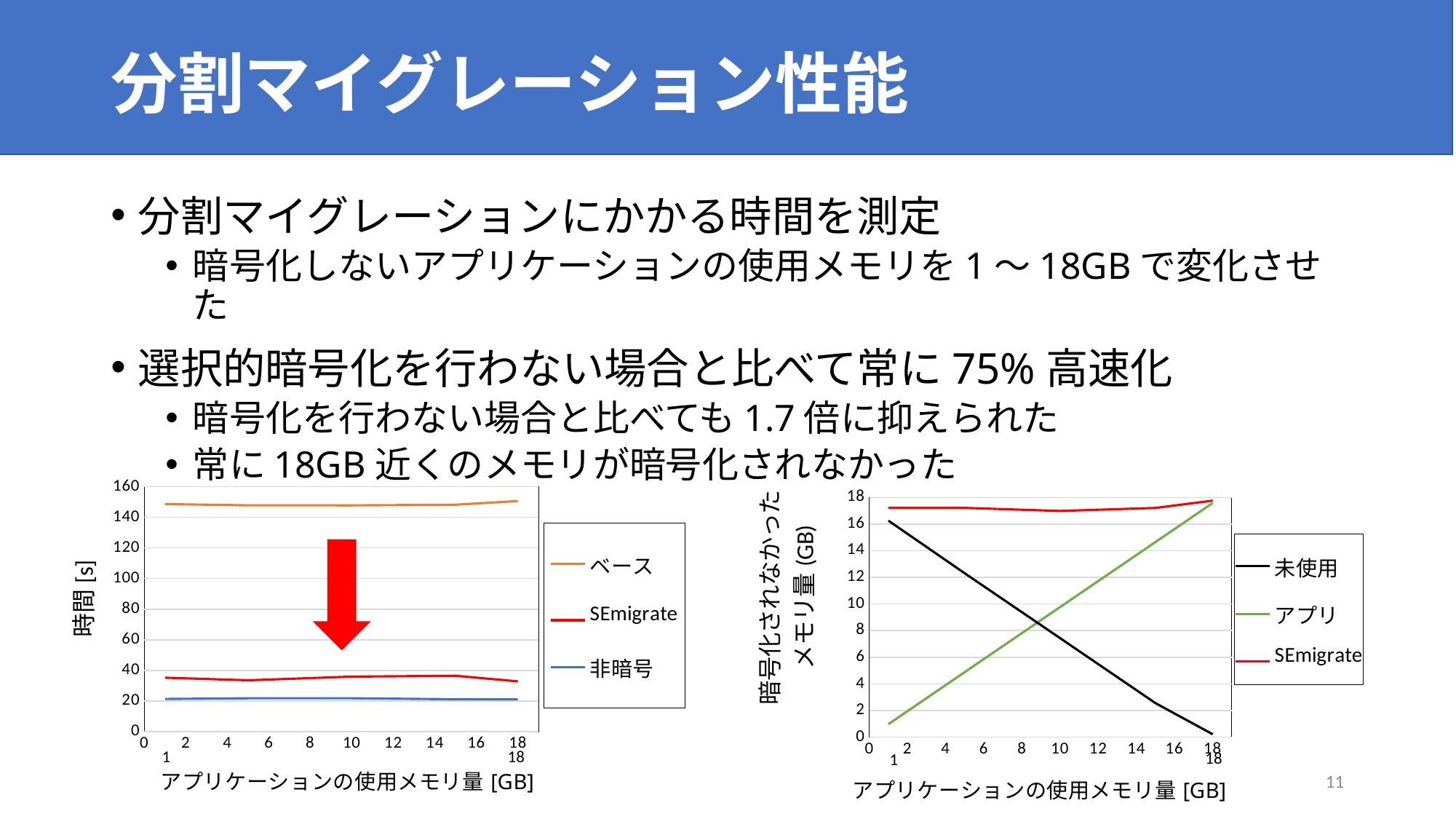
In the left chart, is the value for ベース at 10 GB greater or less than 140? greater In the left chart, which is larger at 8 GB: SEmigrate or 非暗号? SEmigrate In the left chart, which series has the highest values? ベース In the left chart, is the value for SEmigrate at 10 GB greater or less than 40? less What kind of chart is the left chart on the slide? line chart In the left chart, which series has the lowest values? 非暗号 What is the y-axis label of the left chart? 時間 [s] How many series does the legend of the left chart list? 3 How many series does the legend of the right chart list? 3 In the right chart, which is larger at 4 GB: 未使用 or アプリ? 未使用 In the right chart, do the values for アプリ rise or fall as the application memory increases? rise In the right chart, do the values for 未使用 rise or fall as the application memory increases? fall